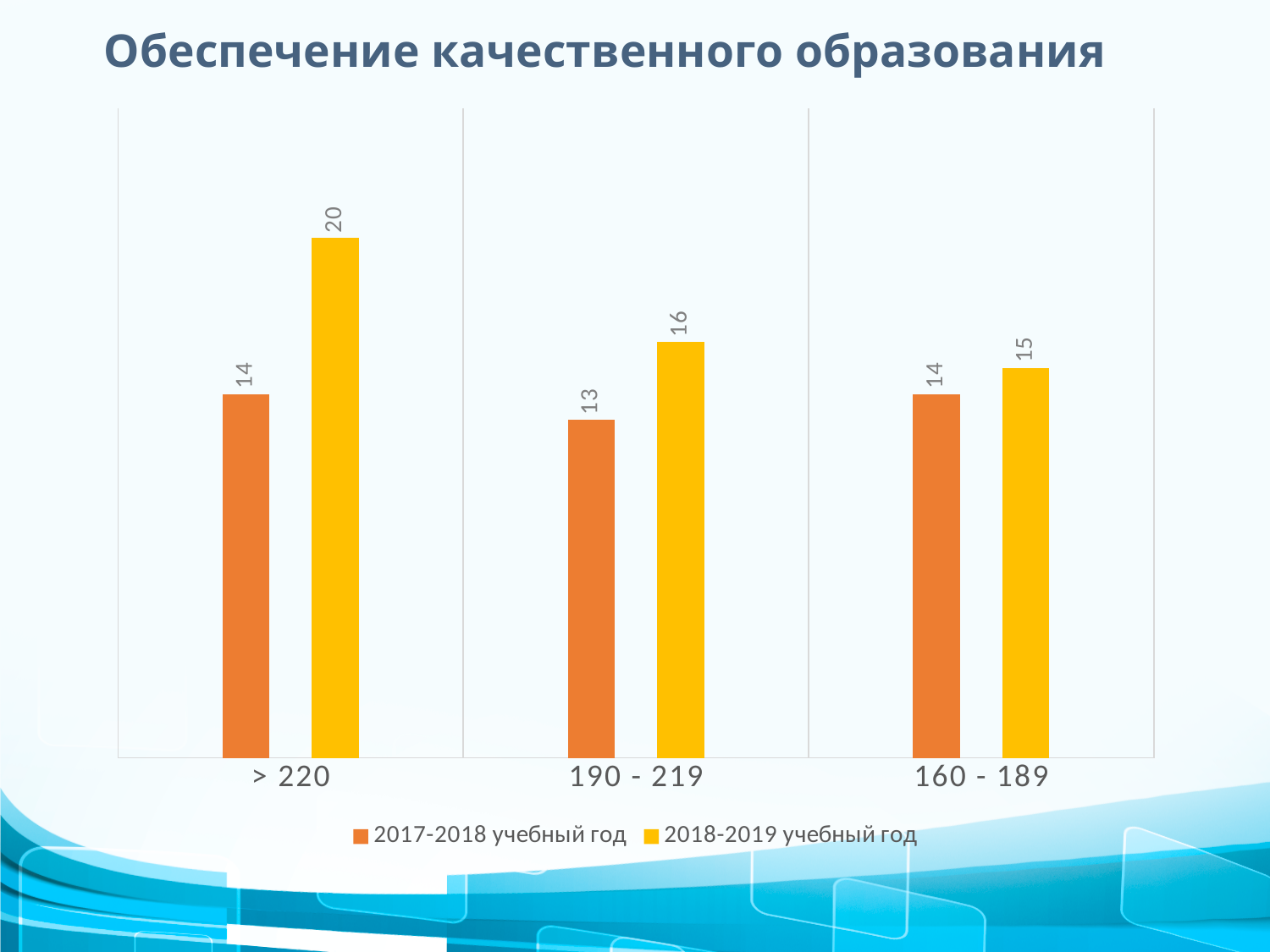
Which is larger for "190 - 219": the 2017-2018 учебный год value or the 2018-2019 учебный год value? 2018-2019 учебный год What is the value for "> 220" in the 2017-2018 учебный год series? 14 Which category has the highest value in the 2018-2019 учебный год series? > 220 What is the difference between the 2018-2019 and 2017-2018 values for "> 220"? 6 What is the value for "190 - 219" in the 2017-2018 учебный год series? 13 What is the value for "> 220" in the 2018-2019 учебный год series? 20 What kind of chart is shown on the slide? Bar chart Which category has the lowest value in the 2017-2018 учебный год series? 190 - 219 What is the title of the slide? Обеспечение качественного образования How many categories are shown on the x axis? 3 What is the value for "160 - 189" in the 2018-2019 учебный год series? 15 How many series does the legend list? 2